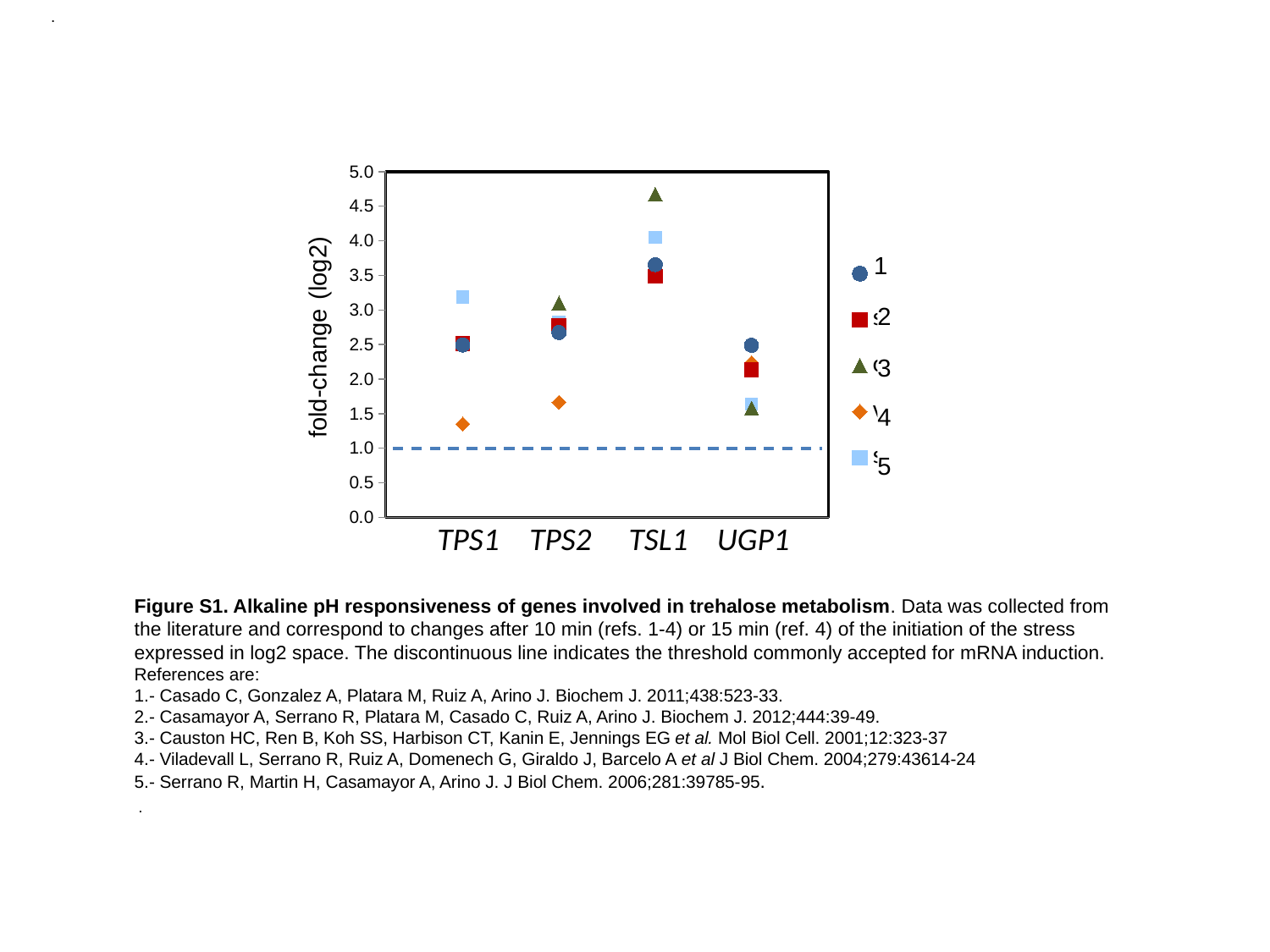
For series 5, which gene has the lowest fold-change? UGP1 At what y-axis value is the dashed horizontal line drawn? 1.0 How many gene categories are shown on the x axis? 4 For series 4, which gene has the lowest fold-change? TPS1 How many series does the legend list? 5 Is the value for series 4 at TPS1 greater or less than 1.5? less For series 5, which is larger: the value at TPS1 or the value at TSL1? TSL1 Is the value for series 3 at TSL1 greater or less than 4.0? greater For series 3, which gene has the highest fold-change? TSL1 What kind of chart is shown on the slide? scatter chart What is the label of the y axis? fold-change (log2) Is the value for series 5 at TPS1 greater or less than 3.0? greater